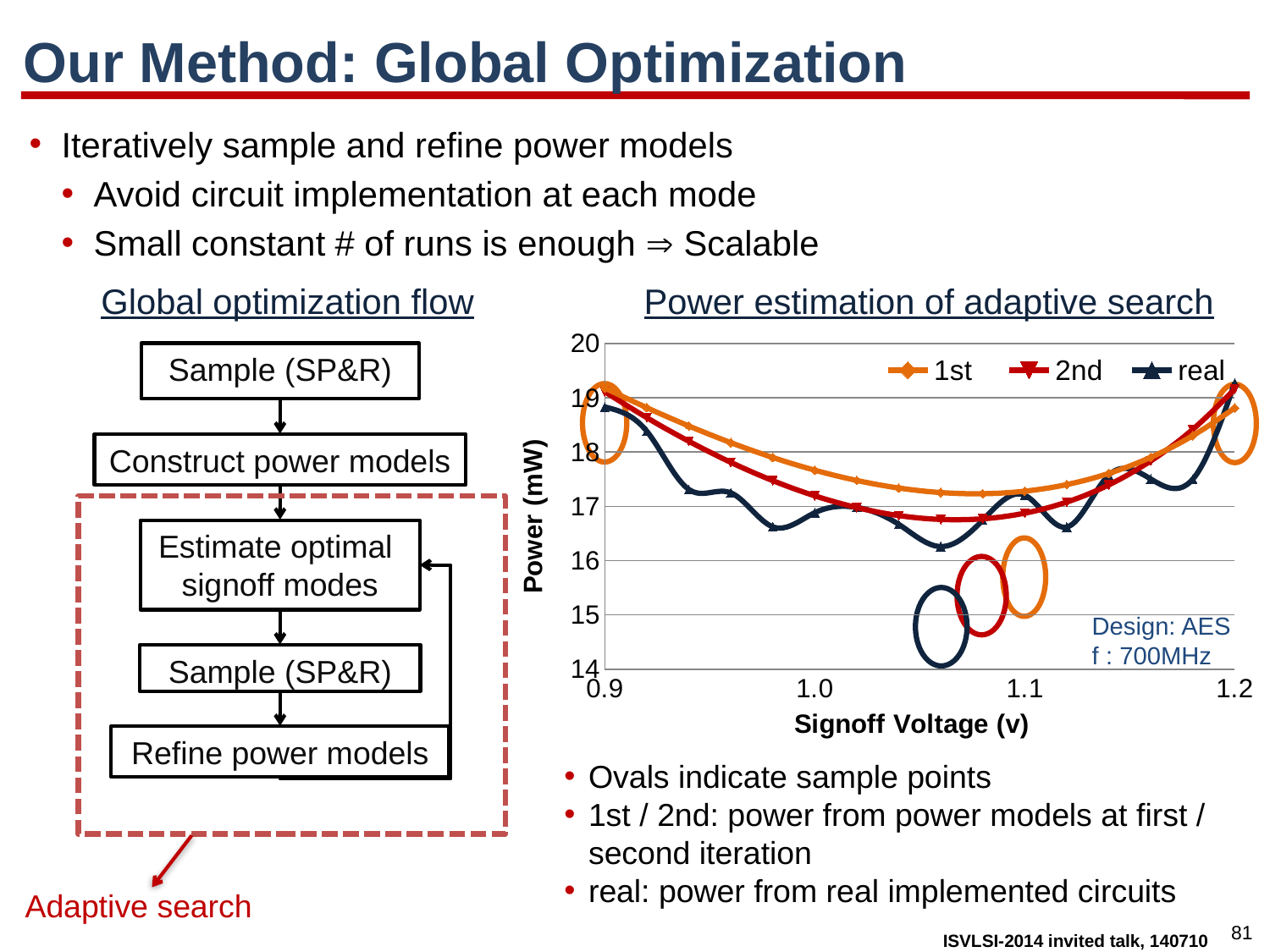
In the 'Power estimation of adaptive search' chart, is the value of the '1st' series at a signoff voltage of 0.9 greater or less than 18? greater What are the three series named in the legend of the 'Power estimation of adaptive search' chart? 1st, 2nd, real In the 'Power estimation of adaptive search' chart, is the value of the 'real' series at a signoff voltage of 1.2 greater or less than 18? greater In the 'Power estimation of adaptive search' chart, which series is larger at a signoff voltage of 1.0, '1st' or 'real'? 1st In the 'Power estimation of adaptive search' chart, which series reaches the lowest power value anywhere on the chart? real What is the x-axis title of the 'Power estimation of adaptive search' chart? Signoff Voltage (v) In the 'Power estimation of adaptive search' chart, how does the '1st' series change as signoff voltage increases from 0.9 to 1.2? falls then rises What type of chart is shown under the title 'Power estimation of adaptive search'? line chart In the 'Power estimation of adaptive search' chart, is the value of the '1st' series at a signoff voltage of 1.0 greater or less than 17? greater How many series does the legend of the 'Power estimation of adaptive search' chart list? 3